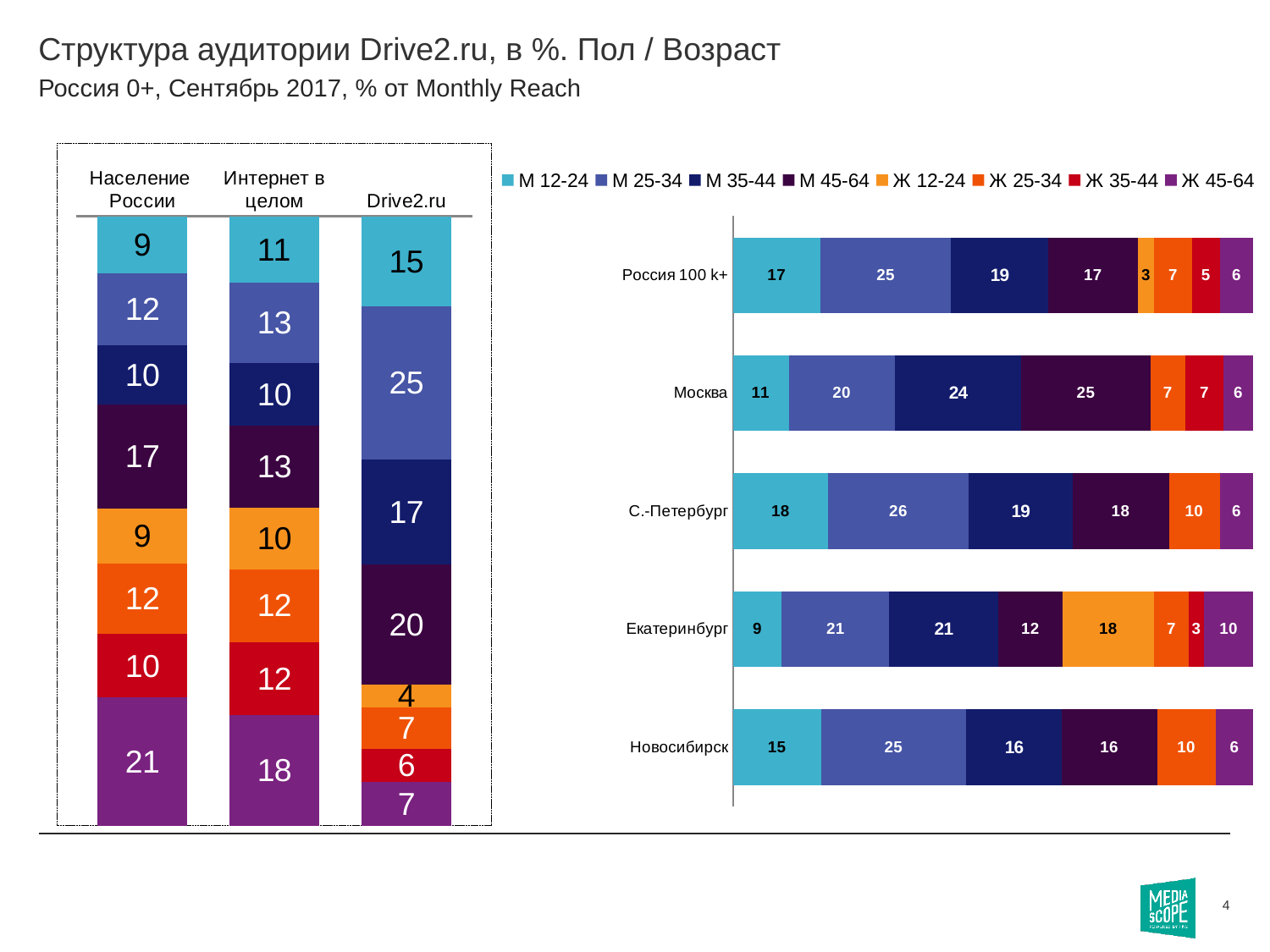
How many cities/regions are shown in the right chart? 5 In the left chart, what is the value for М 25-34 in the Drive2.ru bar? 25 In the left chart, what is the difference between the М 45-64 values for Drive2.ru and Интернет в целом? 7 In the left chart, which segment of the Drive2.ru bar is the largest? М 25-34 In the right chart, what is the value for М 35-44 for Москва? 24 In the left chart, what is the value for Ж 45-64 in the Население России bar? 21 What kind of chart is the right chart? Stacked bar chart How many series does the legend list? 8 In the right chart, what is the value for Ж 12-24 for Екатеринбург? 18 In the left chart, which segment of the Drive2.ru bar is the smallest? Ж 12-24 In the right chart, which is larger: the М 45-64 value for Москва or for Новосибирск? Москва In the right chart, which city has the highest value for М 25-34? С.-Петербург